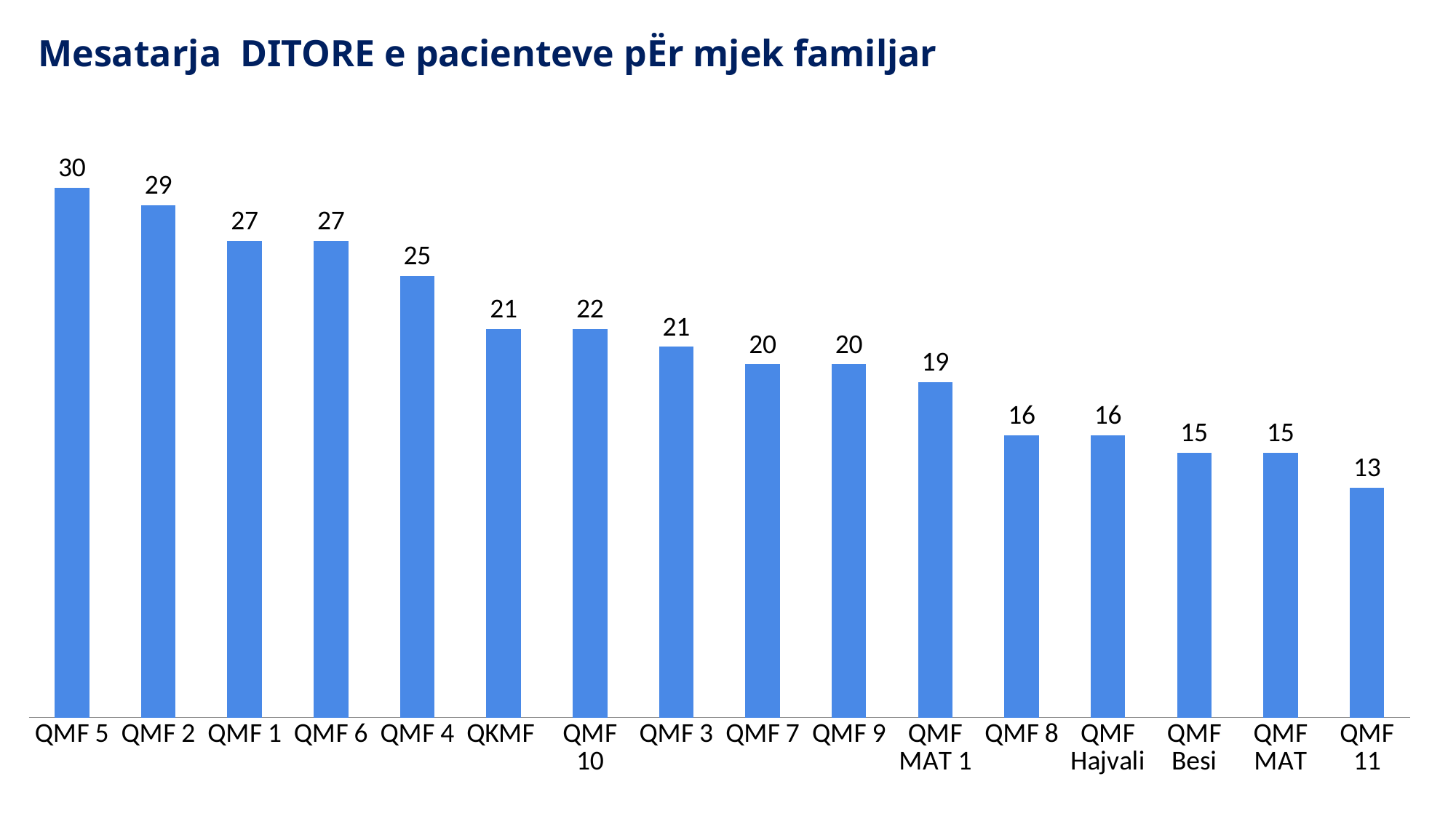
What is the value for QKMF? 21 What is the difference between the values for QMF 2 and QMF 4? 4 What is the value for QMF Hajvali? 16 What kind of chart is shown on the slide? Bar chart Which category has the lowest value? QMF 11 What is the value for QMF MAT 1? 19 Which is larger, the value for QMF 10 or the value for QMF 7? QMF 10 What is the title of the chart? Mesatarja DITORE e pacienteve pËr mjek familjar Which category has the highest value? QMF 5 What is the difference between the values for QMF 5 and QMF 11? 17 How many categories are shown on the chart? 16 What is the value for QMF 5? 30